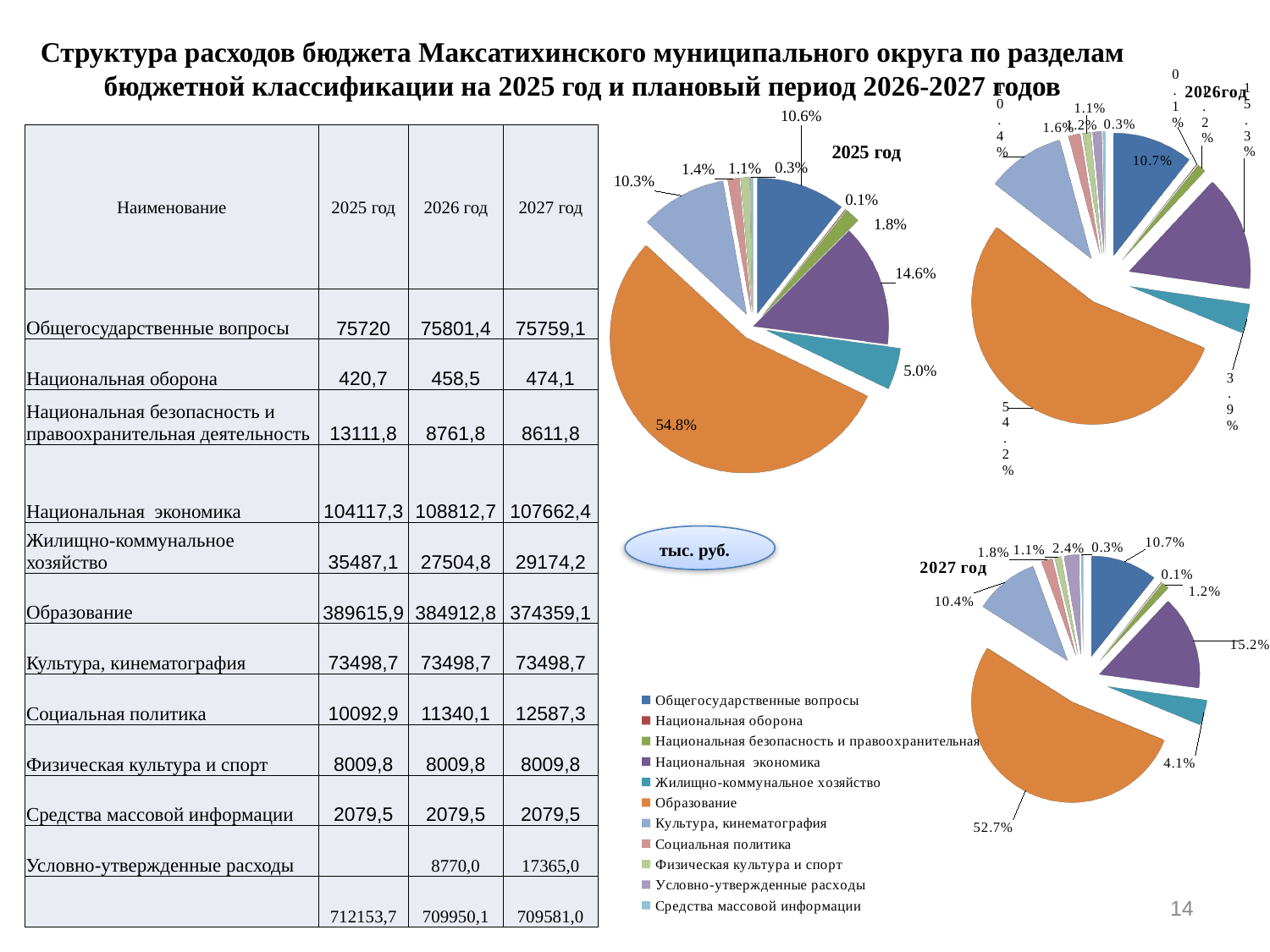
In the 2025 год pie chart, which category has the largest slice? Образование What kind of charts are shown on the slide? Pie charts In the 2025 год pie chart, what share does Жилищно-коммунальное хозяйство have? 5.0% In the 2027 год pie chart, what share does Жилищно-коммунальное хозяйство have? 4.1% In the 2027 год pie chart, what share does Образование have? 52.7% In the 2027 год pie chart, what share does Национальная экономика have? 15.2% In the 2025 год pie chart, what share does Национальная экономика have? 14.6% In the 2026 год pie chart, what share does Общегосударственные вопросы have? 10.7% In the 2027 год pie chart, which is larger: the slice for Общегосударственные вопросы or the slice for Жилищно-коммунальное хозяйство? Общегосударственные вопросы In the 2025 год pie chart, what share does Образование have? 54.8% How many entries does the legend list for the pie charts? 11 What is the difference between the Образование share in the 2025 год pie chart (54.8%) and in the 2027 год pie chart (52.7%)? 2.1%